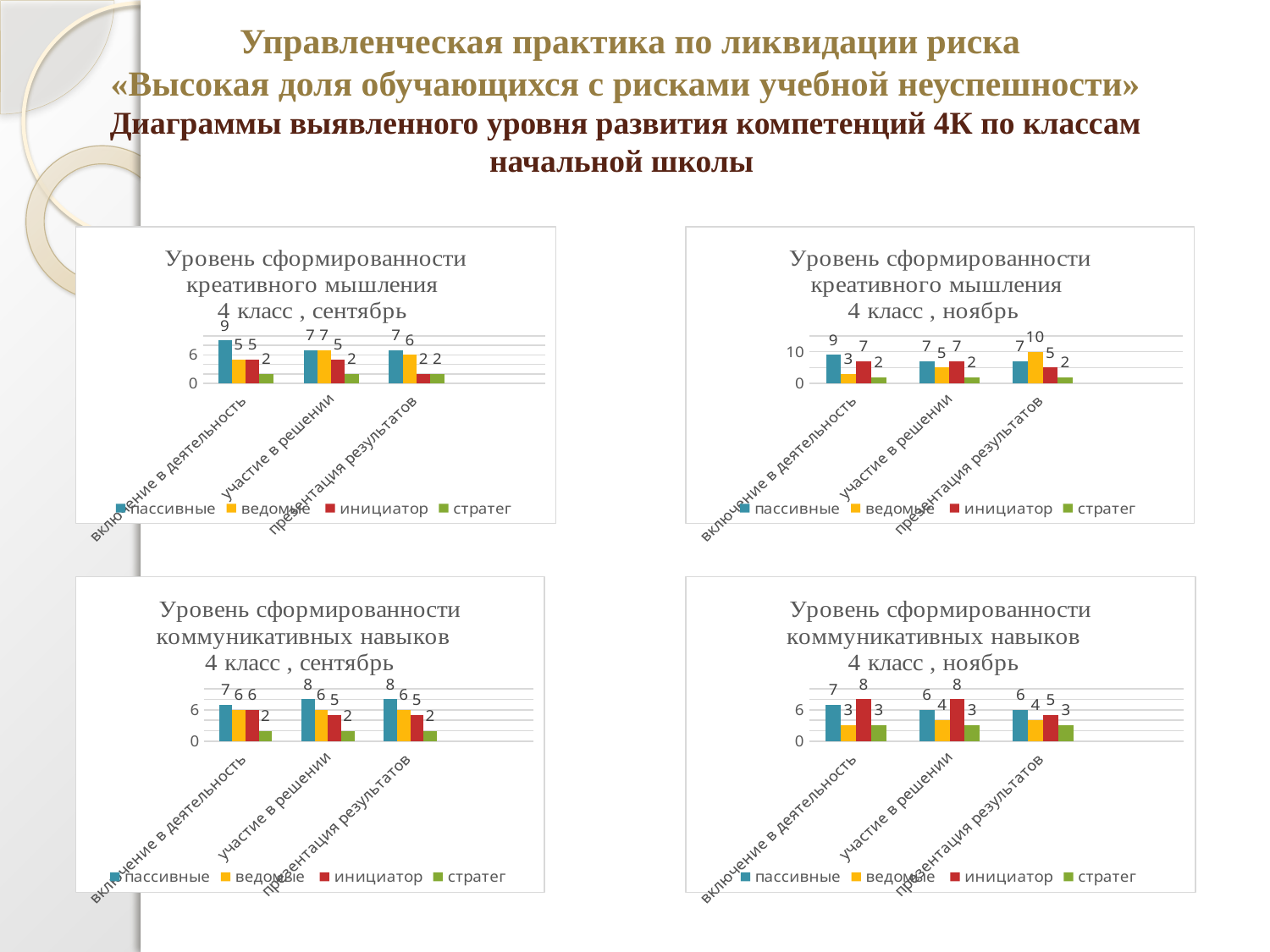
In the top-left chart (креативное мышление, 4 класс, сентябрь), what is the value for пассивные in the category включение в деятельность? 9 How many categories are shown on the x axis of the top-right chart (креативное мышление, 4 класс, ноябрь)? 3 What kind of chart is the bottom-left chart (коммуникативные навыки, 4 класс, сентябрь)? bar chart How many series does the legend of the bottom-left chart (коммуникативные навыки, 4 класс, сентябрь) list? 4 In the bottom-right chart (коммуникативные навыки, 4 класс, ноябрь), what is the value for стратег in the category включение в деятельность? 3 In the bottom-left chart (коммуникативные навыки, 4 класс, сентябрь), what is the value for инициатор in the category участие в решении? 5 In the bottom-right chart (коммуникативные навыки, 4 класс, ноябрь), which is larger in the category включение в деятельность: пассивные or инициатор? инициатор In the top-left chart (креативное мышление, 4 класс, сентябрь), what colour represents the series инициатор? red In the bottom-right chart (коммуникативные навыки, 4 класс, ноябрь), which series has the lowest value in the category участие в решении? стратег In the top-left chart (креативное мышление, 4 класс, сентябрь), what is the difference between пассивные and стратег in the category включение в деятельность? 7 In the top-right chart (креативное мышление, 4 класс, ноябрь), what is the value for ведомые in the category презентация результатов? 10 In the top-right chart (креативное мышление, 4 класс, ноябрь), which series has the highest value in the category презентация результатов? ведомые